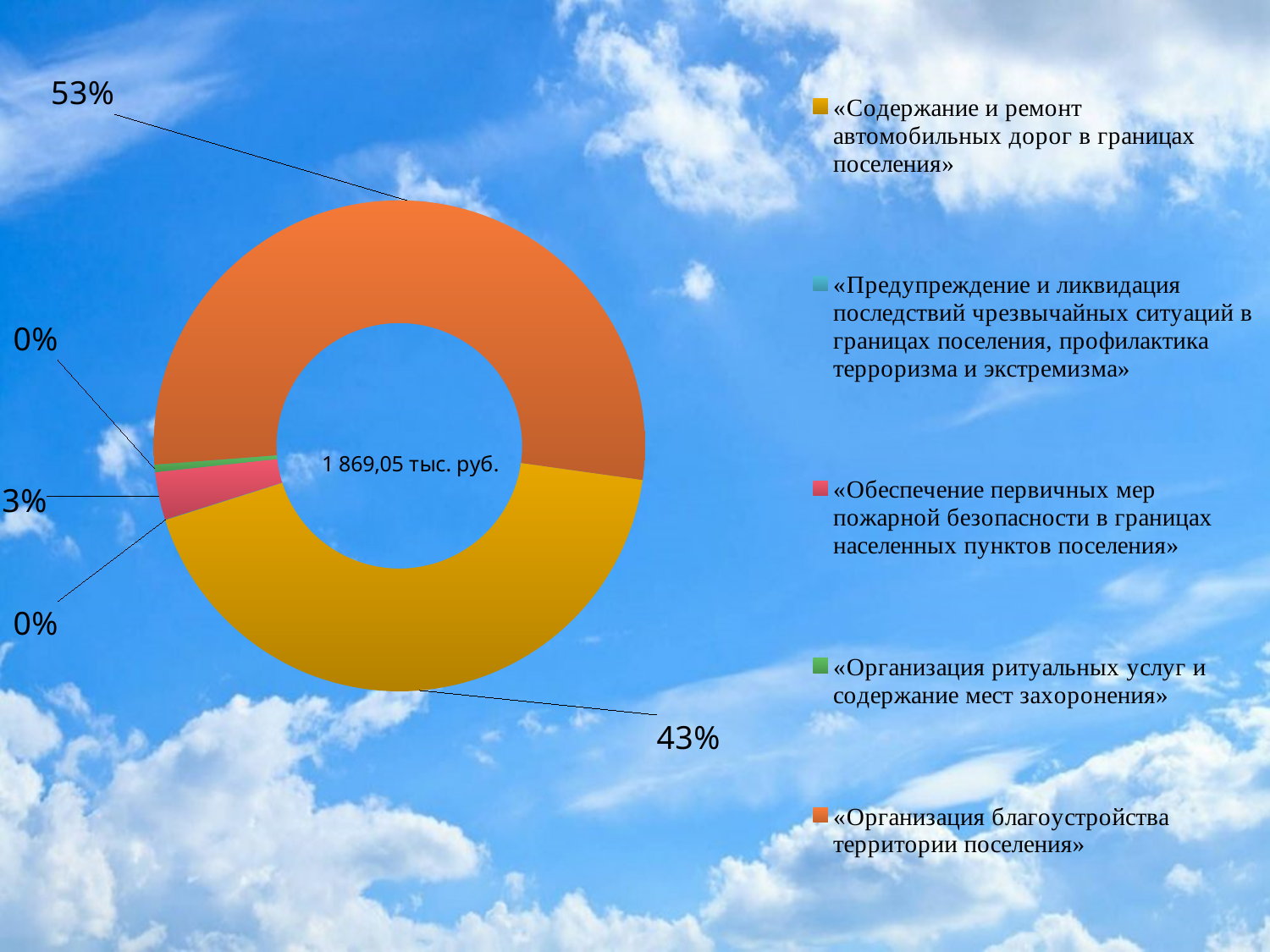
What kind of chart is shown on the slide? Doughnut (pie) chart What share of the chart does «Содержание и ремонт автомобильных дорог в границах поселения» have? 43% What share of the chart does «Организация благоустройства территории поселения» have? 53% How many slices are labelled 0% on the chart? 2 What share of the chart does «Обеспечение первичных мер пожарной безопасности в границах населенных пунктов поселения» have? 3% What total amount is printed in the centre of the doughnut chart? 1 869,05 тыс. руб. Which is larger: the slice for «Содержание и ремонт автомобильных дорог в границах поселения» or the slice for «Организация благоустройства территории поселения»? «Организация благоустройства территории поселения» Which category has the largest slice of the chart? «Организация благоустройства территории поселения» What colour is the slice for «Обеспечение первичных мер пожарной безопасности в границах населенных пунктов поселения»? Pink/red How many categories does the legend list? 5 What is the difference in percentage points between the largest slice (53%) and the second largest slice (43%)? 10